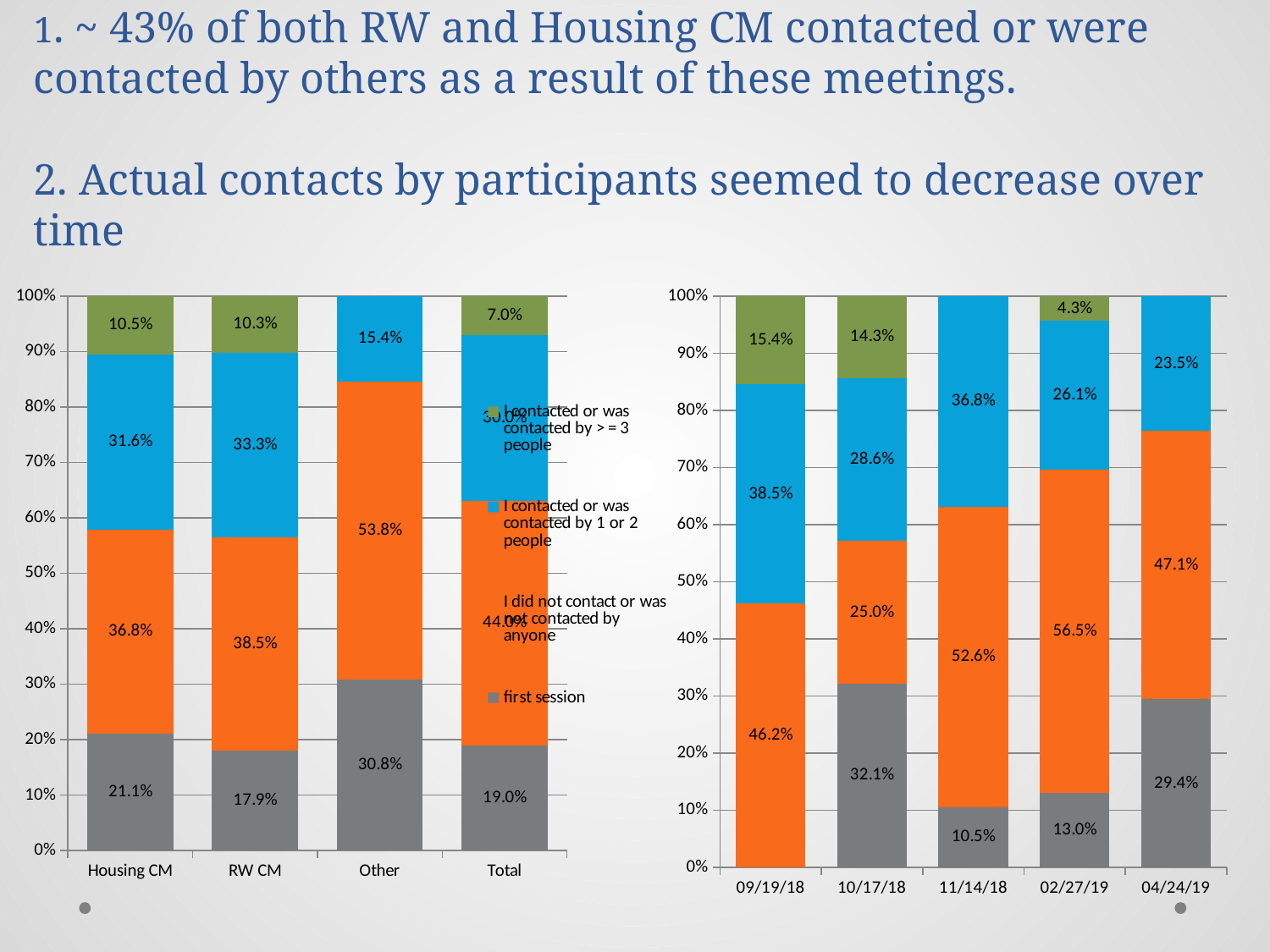
In the left chart, what is the 'first session' value for the Other category? 30.8% In the left chart, which category has the lowest 'first session' value? RW CM What type of chart is the right chart? Stacked bar chart How many series does the legend on the left chart list? 4 In the right chart, which date has the highest 'I contacted or was contacted by 1 or 2 people' value? 09/19/18 In the right chart, what is the 'first session' value for 11/14/18? 10.5% In the right chart, what is the difference between the 'first session' values for 10/17/18 and 04/24/19? 2.7% How many dates are shown on the x axis of the right chart? 5 In the left chart, what percentage of Housing CM participants did not contact or were not contacted by anyone? 36.8% In the left chart, what is the value for 'I contacted or was contacted by >= 3 people' in the Total category? 7.0% In the right chart, what is the 'I did not contact or was not contacted by anyone' value for 02/27/19? 56.5% In the left chart, which is larger: the 'I contacted or was contacted by 1 or 2 people' value for RW CM or for Other? RW CM